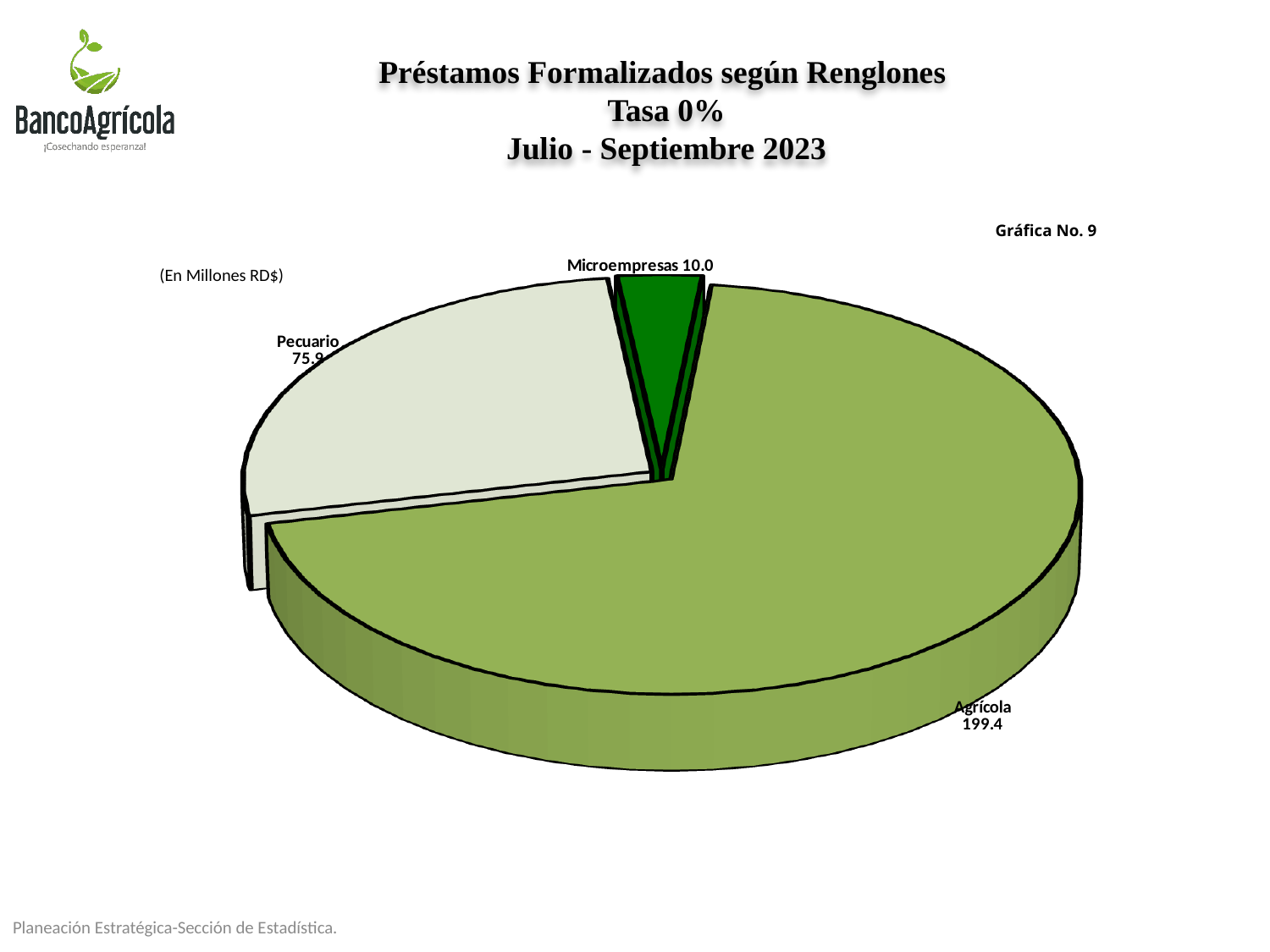
What is the difference between the values for Agrícola and Microempresas? 189.4 What kind of chart is shown on the slide? pie chart Which category has the smallest slice of the pie? Microempresas What is the value for Pecuario? 75.9 How many slices does the pie chart have? 3 What is the difference between the values for Agrícola and Pecuario? 123.5 What is the value for Microempresas? 10.0 What graph number is given on the slide? Gráfica No. 9 Which is larger, the value for Pecuario or the value for Microempresas? Pecuario In what units are the values on the chart expressed? En Millones RD$ Which category has the largest slice of the pie? Agrícola What is the value for Agrícola? 199.4